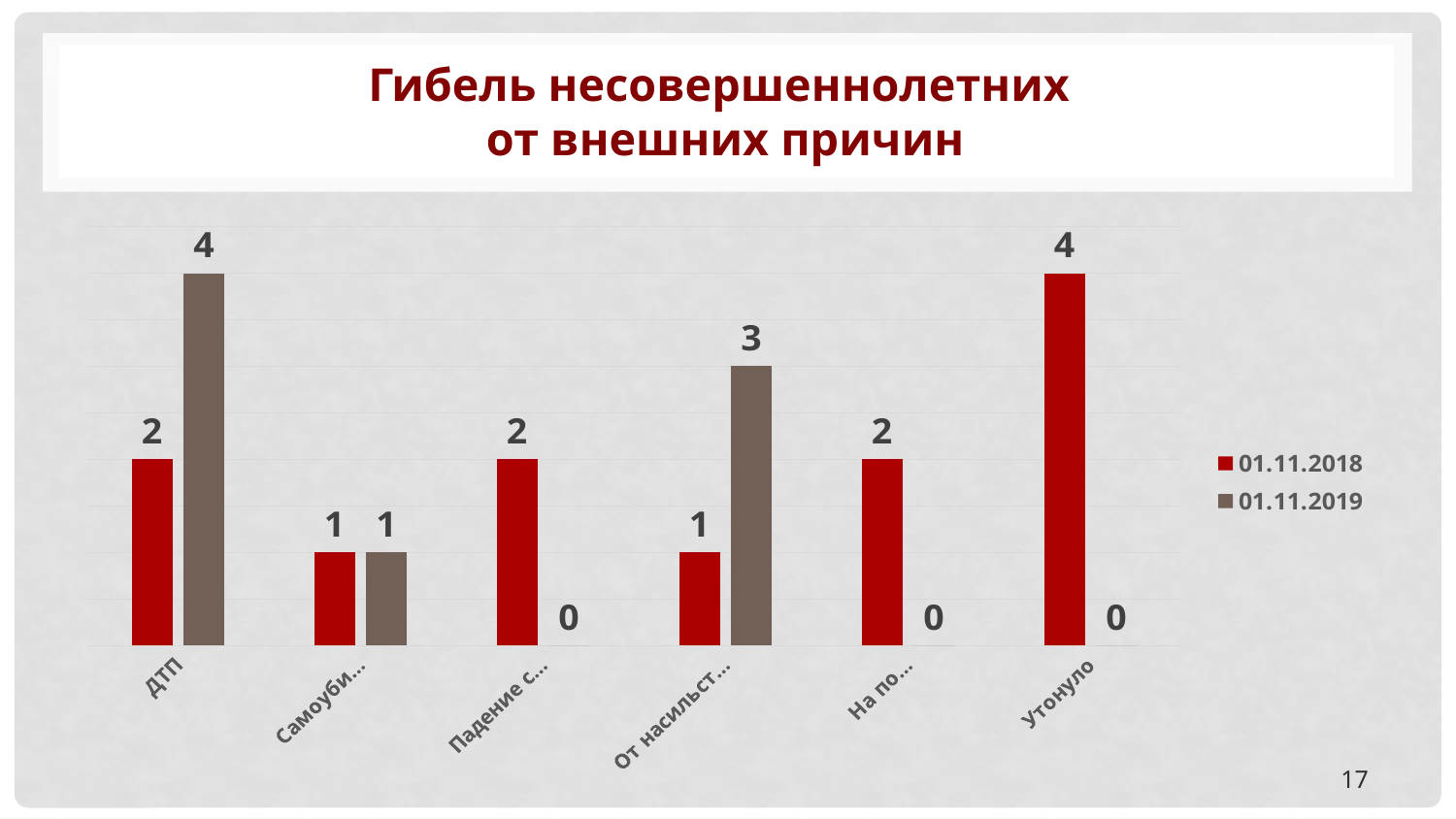
How many series does the legend list? 2 For ДТП, which series has the larger value, 01.11.2018 or 01.11.2019? 01.11.2019 By how much does the 01.11.2019 value for ДТП exceed the 01.11.2018 value for ДТП? 2 Which category has the highest value in the 01.11.2018 series? Утонуло Which category has the highest value in the 01.11.2019 series? ДТП What kind of chart is shown on the slide? bar chart What is the value for ДТП in the 01.11.2019 series? 4 What is the value for ДТП in the 01.11.2018 series? 2 How many categories are shown on the x axis of the chart? 6 What is the value for Утонуло in the 01.11.2019 series? 0 What is the value for Утонуло in the 01.11.2018 series? 4 What is the title of the slide? Гибель несовершеннолетних от внешних причин